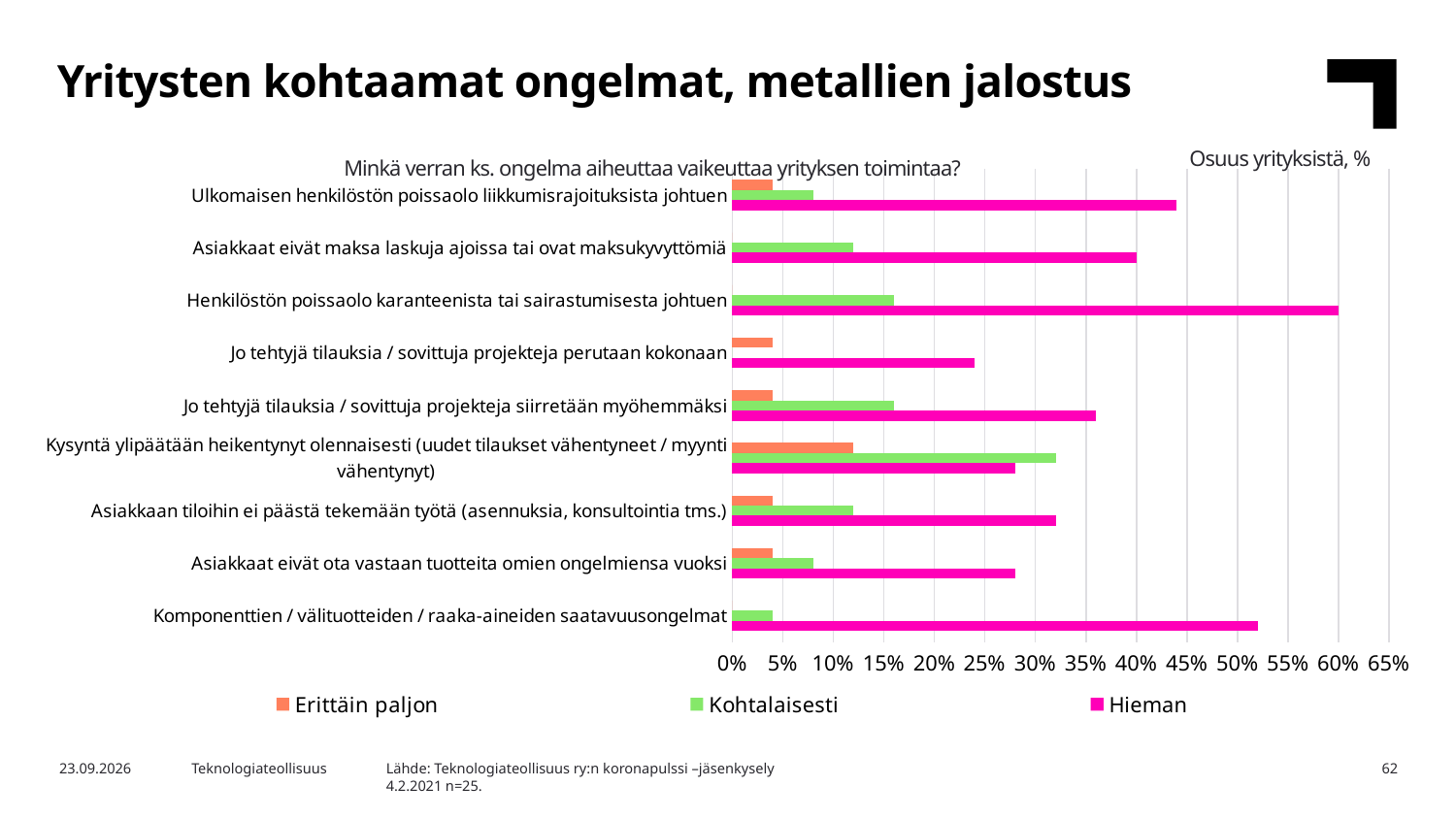
What kind of chart is shown on the slide? bar chart How many series does the legend list? 3 Which category has the highest 'Erittäin paljon' value? Kysyntä ylipäätään heikentynyt olennaisesti (uudet tilaukset vähentyneet / myynti vähentynyt) What colour represents the 'Hieman' series in the chart? magenta (pink) What is the 'Hieman' value for 'Asiakkaat eivät maksa laskuja ajoissa tai ovat maksukyvyttömiä'? 40% Is the 'Hieman' value for 'Komponenttien / välituotteiden / raaka-aineiden saatavuusongelmat' greater or less than 50%? greater Which category has the highest value for the 'Hieman' series? Henkilöstön poissaolo karanteenista tai sairastumisesta johtuen Which is larger for 'Ulkomaisen henkilöstön poissaolo liikkumisrajoituksista johtuen': the 'Hieman' value or the 'Kohtalaisesti' value? Hieman Is the 'Hieman' value for 'Jo tehtyjä tilauksia / sovittuja projekteja perutaan kokonaan' greater or less than 30%? less How many categories (problems) are plotted on the chart? 9 Is the 'Kohtalaisesti' value for 'Kysyntä ylipäätään heikentynyt olennaisesti' greater or less than 30%? greater What is the 'Hieman' value for 'Henkilöstön poissaolo karanteenista tai sairastumisesta johtuen'? 60%